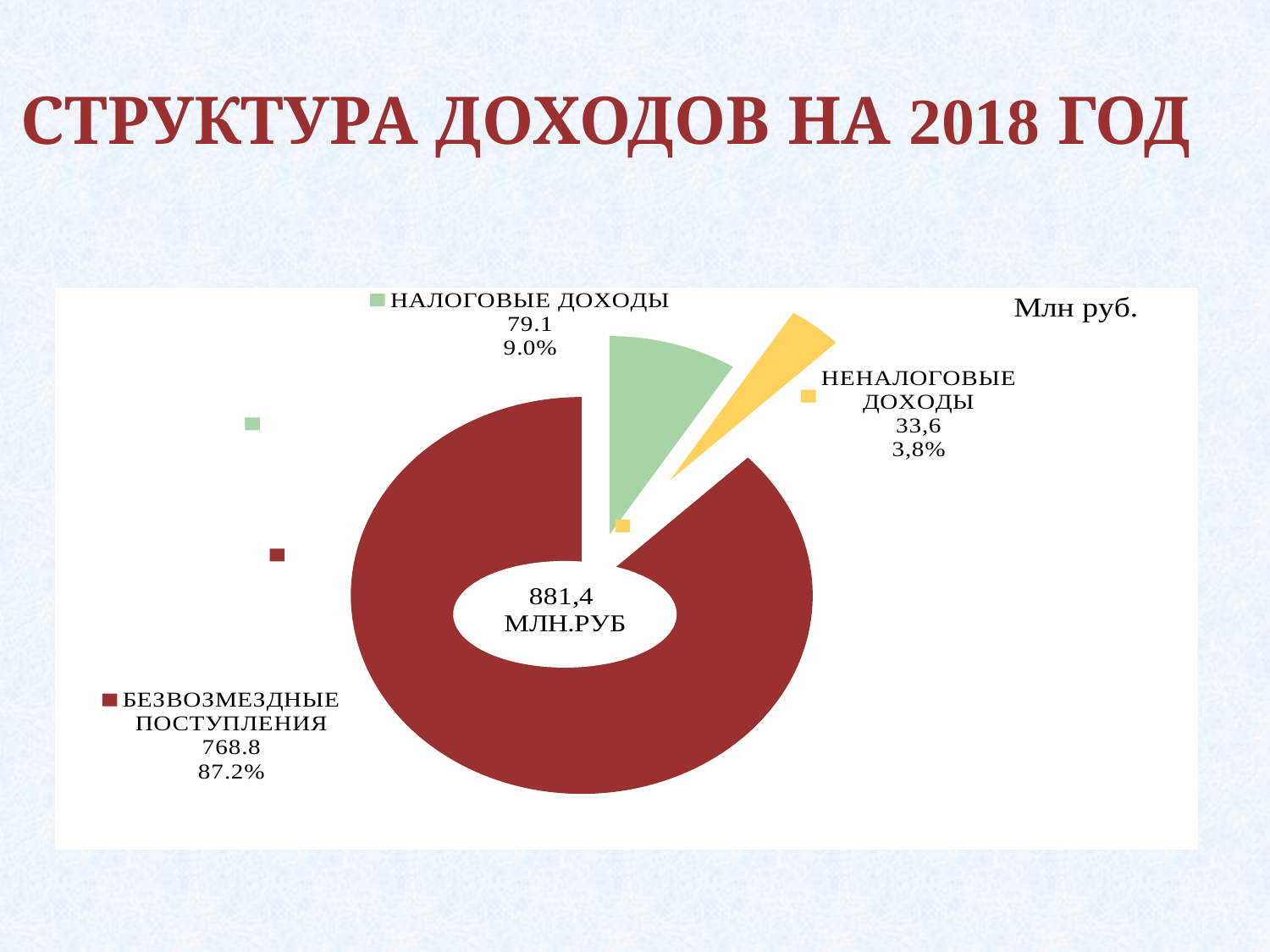
How many categories are shown in the pie chart? 3 What share of the pie does БЕЗВОЗМЕЗДНЫЕ ПОСТУПЛЕНИЯ represent? 87.2% What share of the pie does НАЛОГОВЫЕ ДОХОДЫ represent? 9.0% What is the value for НАЛОГОВЫЕ ДОХОДЫ? 79.1 What kind of chart is shown on the slide? pie chart What is the value for НЕНАЛОГОВЫЕ ДОХОДЫ? 33,6 What share of the pie does НЕНАЛОГОВЫЕ ДОХОДЫ represent? 3,8% What is the value for БЕЗВОЗМЕЗДНЫЕ ПОСТУПЛЕНИЯ? 768.8 What is the difference between the values for НАЛОГОВЫЕ ДОХОДЫ and НЕНАЛОГОВЫЕ ДОХОДЫ? 45.5 Which category has the smallest slice? НЕНАЛОГОВЫЕ ДОХОДЫ Which category has the largest slice? БЕЗВОЗМЕЗДНЫЕ ПОСТУПЛЕНИЯ What total value is printed in the centre of the chart? 881,4 МЛН.РУБ